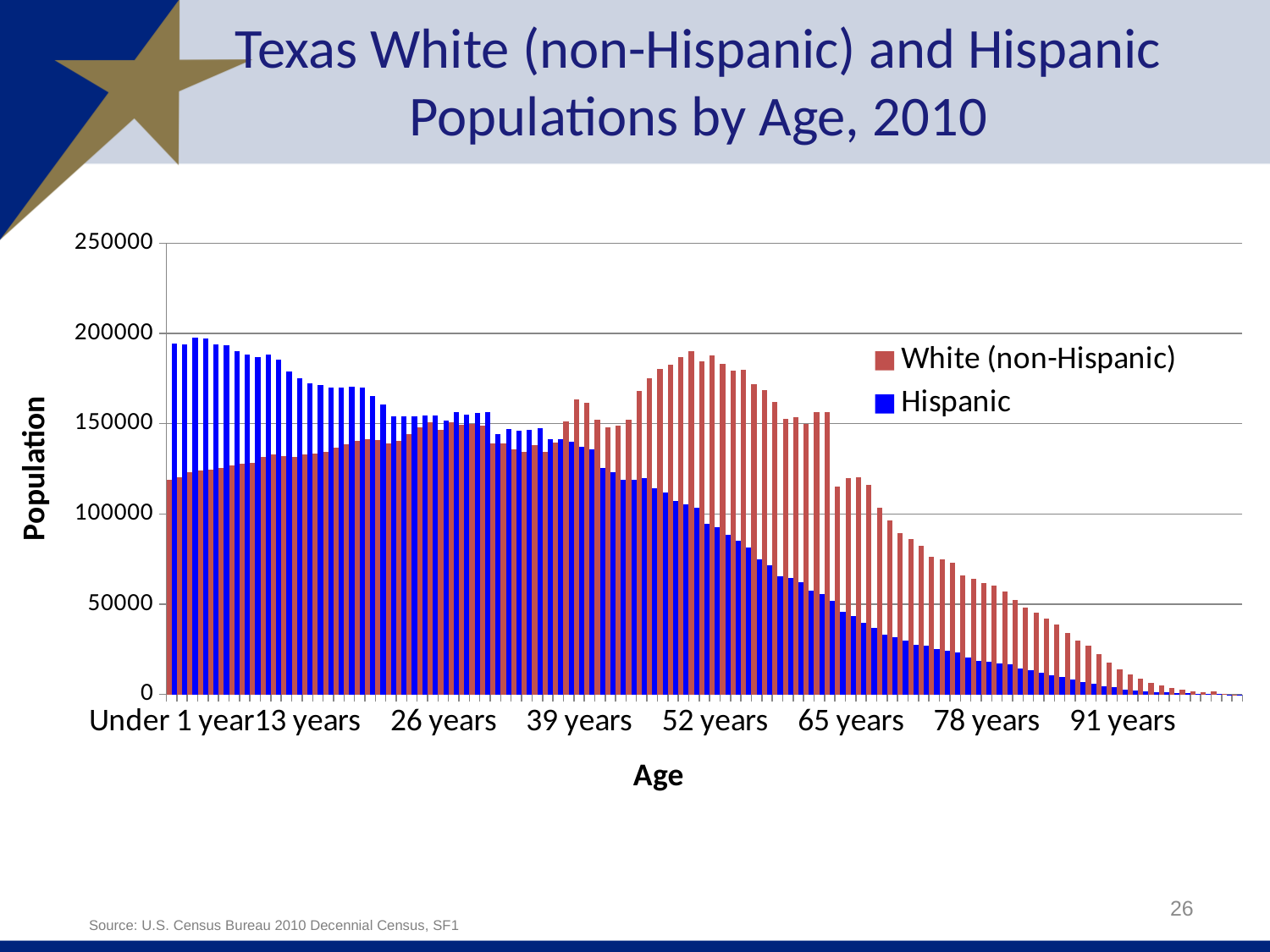
What colour are the bars for the Hispanic series? Blue At 52 years, which series has the larger population, White (non-Hispanic) or Hispanic? White (non-Hispanic) Is the White (non-Hispanic) population at 52 years greater or less than 150000? greater Is the Hispanic population at 78 years greater or less than 50000? less Is the White (non-Hispanic) population for Under 1 year greater or less than 150000? less Does the Hispanic population generally rise or fall as age increases along the x axis? Fall What kind of chart is shown on the slide? Bar chart At Under 1 year, which series has the larger population, White (non-Hispanic) or Hispanic? Hispanic How many series does the legend list? 2 Which two series are listed in the chart legend? White (non-Hispanic) and Hispanic